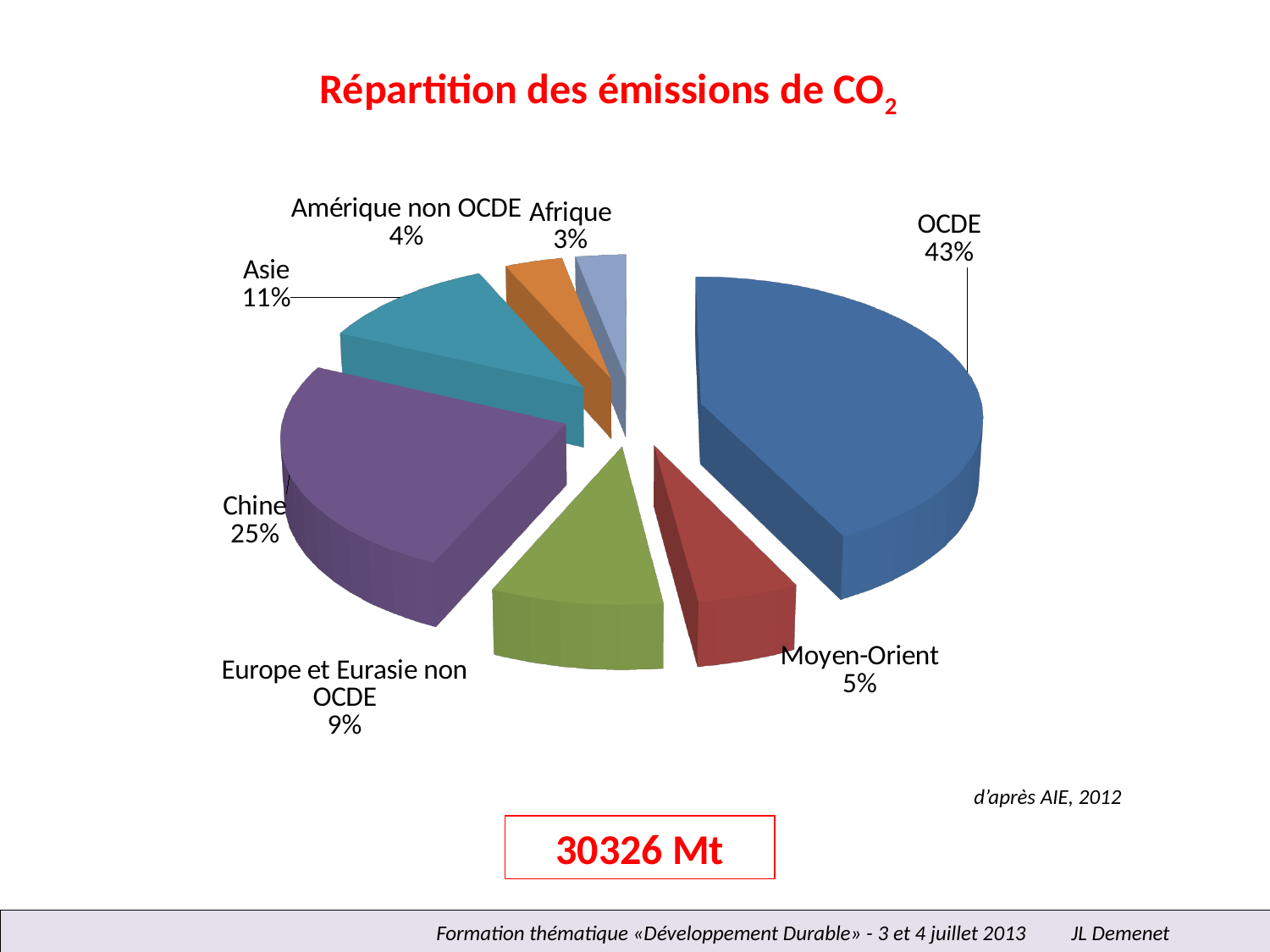
How many regions are shown in the pie chart? 7 What share of CO2 emissions does Europe et Eurasie non OCDE account for? 9% What share of CO2 emissions does Asie account for? 11% Which has a larger share of CO2 emissions, Asie or Europe et Eurasie non OCDE? Asie What share of CO2 emissions does OCDE account for? 43% What share of CO2 emissions does Moyen-Orient account for? 5% What kind of chart is shown on the slide? Pie chart Which region has the largest share of CO2 emissions? OCDE What total amount of CO2 emissions is shown in the box below the chart? 30326 Mt What is the difference in percentage points between the OCDE share and the Chine share? 18 Which region has the smallest share of CO2 emissions? Afrique What share of CO2 emissions does Chine account for? 25%